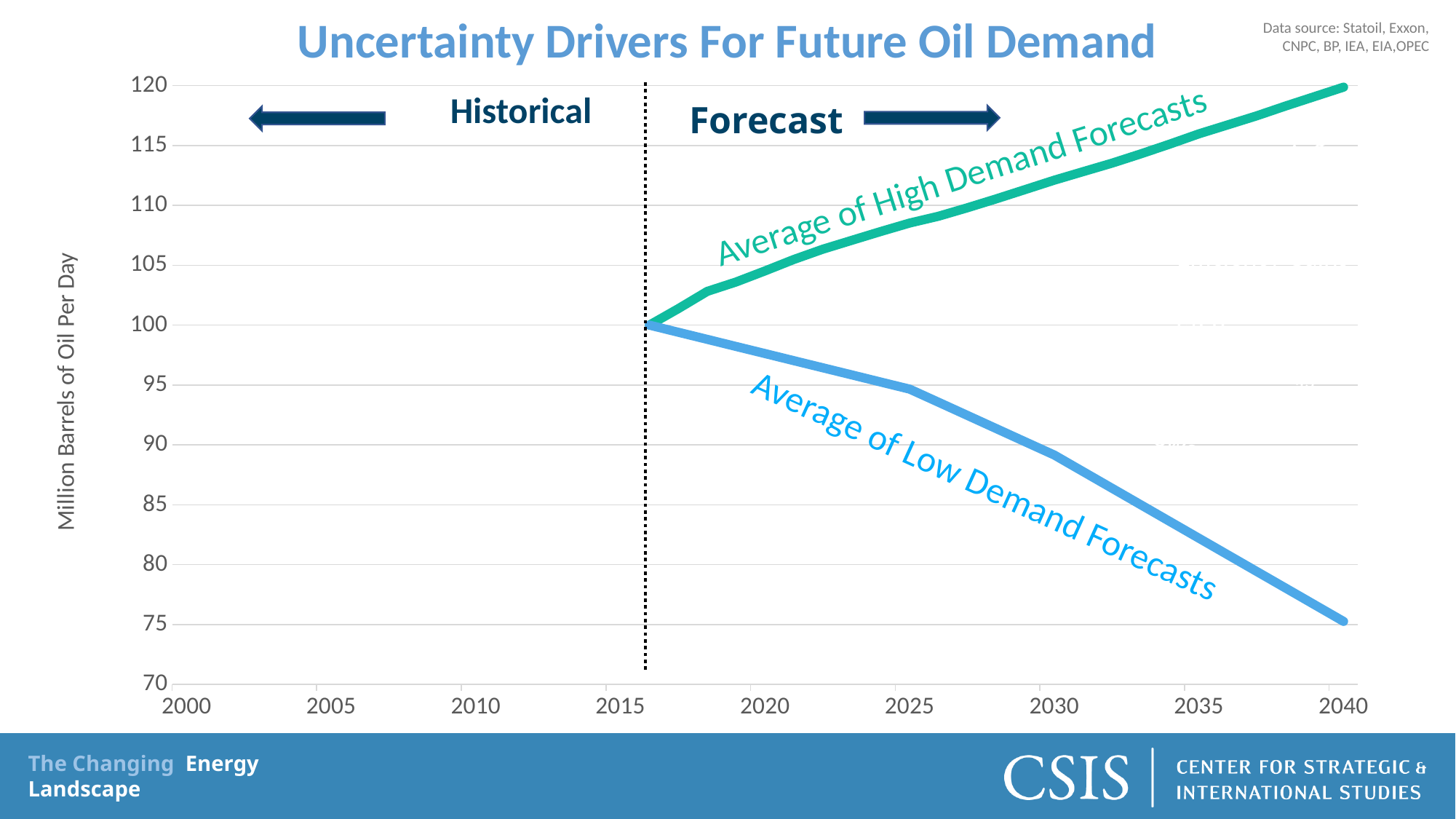
Is the value for Average of High Demand Forecasts in 2030 greater or less than 105? greater Is the value for Average of High Demand Forecasts in 2040 greater or less than 115? greater What is the title of the chart? Uncertainty Drivers For Future Oil Demand Does the Average of High Demand Forecasts line rise or fall from 2016 to 2040? rise How many data series (lines) are plotted on the chart? 2 Is the value for Average of Low Demand Forecasts in 2025 greater or less than 100? less Does the Average of Low Demand Forecasts line rise or fall from 2016 to 2040? fall What is the label on the vertical axis of the chart? Million Barrels of Oil Per Day What kind of chart is shown on the slide? line chart In 2040, which line is higher: Average of High Demand Forecasts or Average of Low Demand Forecasts? Average of High Demand Forecasts